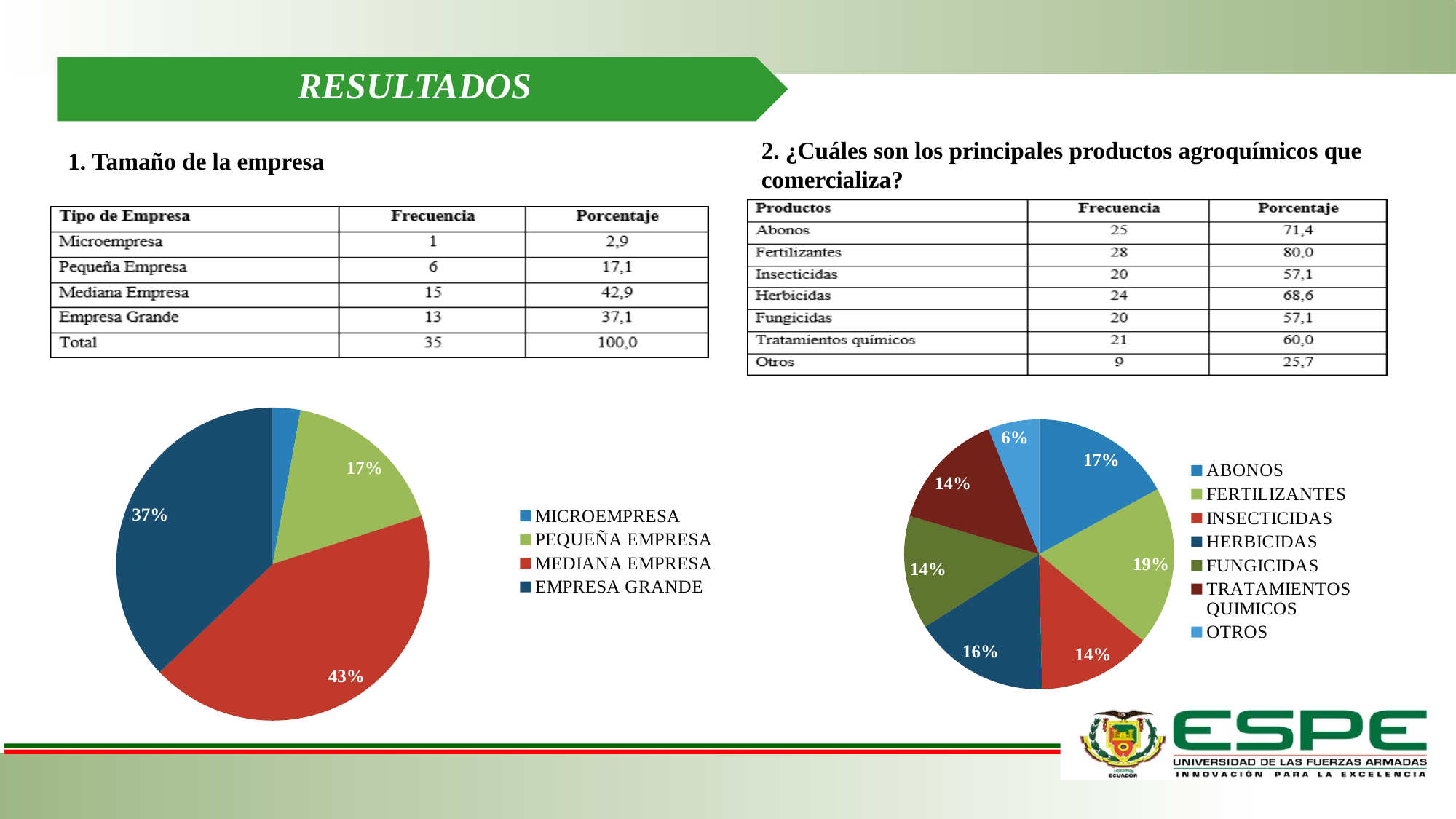
In the right pie chart, what share is shown for FERTILIZANTES? 19% In the right pie chart, how many categories does the legend list? 7 In the left pie chart, what share is shown for EMPRESA GRANDE? 37% In the left pie chart, what share is shown for MEDIANA EMPRESA? 43% In the left pie chart, what is the difference between the shares of MEDIANA EMPRESA and PEQUEÑA EMPRESA? 26% In the left pie chart, which category has the smallest slice? MICROEMPRESA In the left pie chart, how many categories does the legend list? 4 In the right pie chart, which category has the largest slice? FERTILIZANTES In the right pie chart, what share is shown for OTROS? 6% In the right pie chart, which category has the smallest slice? OTROS In the left pie chart, which category has the largest slice? MEDIANA EMPRESA What type of chart is the chart on the right side of the slide? Pie chart